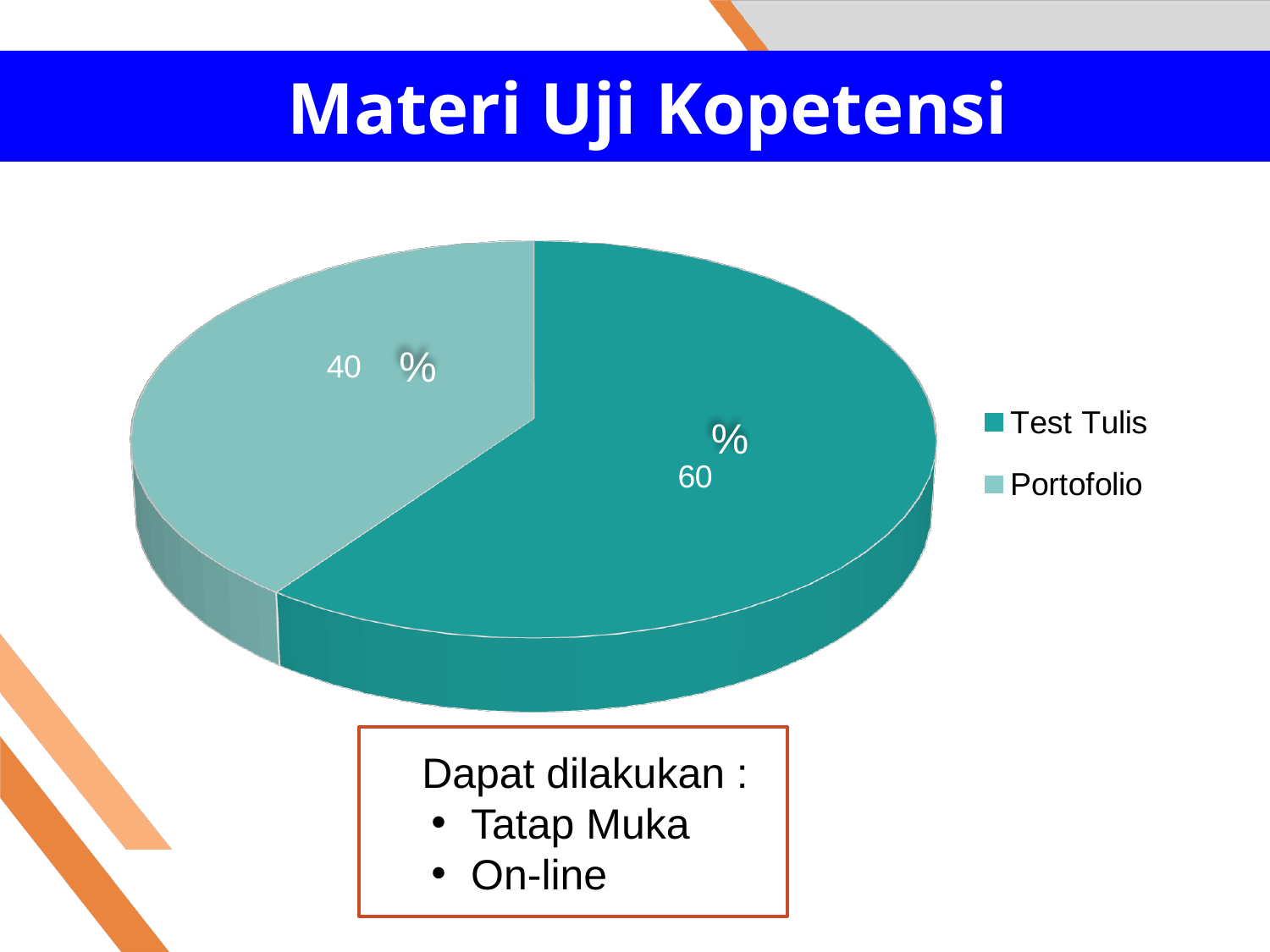
What is the difference between the Test Tulis and Portofolio values in the pie chart? 20% How many entries does the legend of the pie chart list? 2 Which category has the smallest slice in the pie chart? Portofolio What is the value shown for the Portofolio slice of the pie chart? 40% Which category has the largest slice in the pie chart? Test Tulis What is the title of the slide containing the pie chart? Materi Uji Kopetensi What share of the pie does the Portofolio slice represent? 40% What is the value shown for the Test Tulis slice of the pie chart? 60% Which is larger in the pie chart, Test Tulis or Portofolio? Test Tulis Which legend entry is shown in the lighter teal colour in the pie chart? Portofolio What type of chart is shown on the slide? Pie chart How many slices does the pie chart have? 2